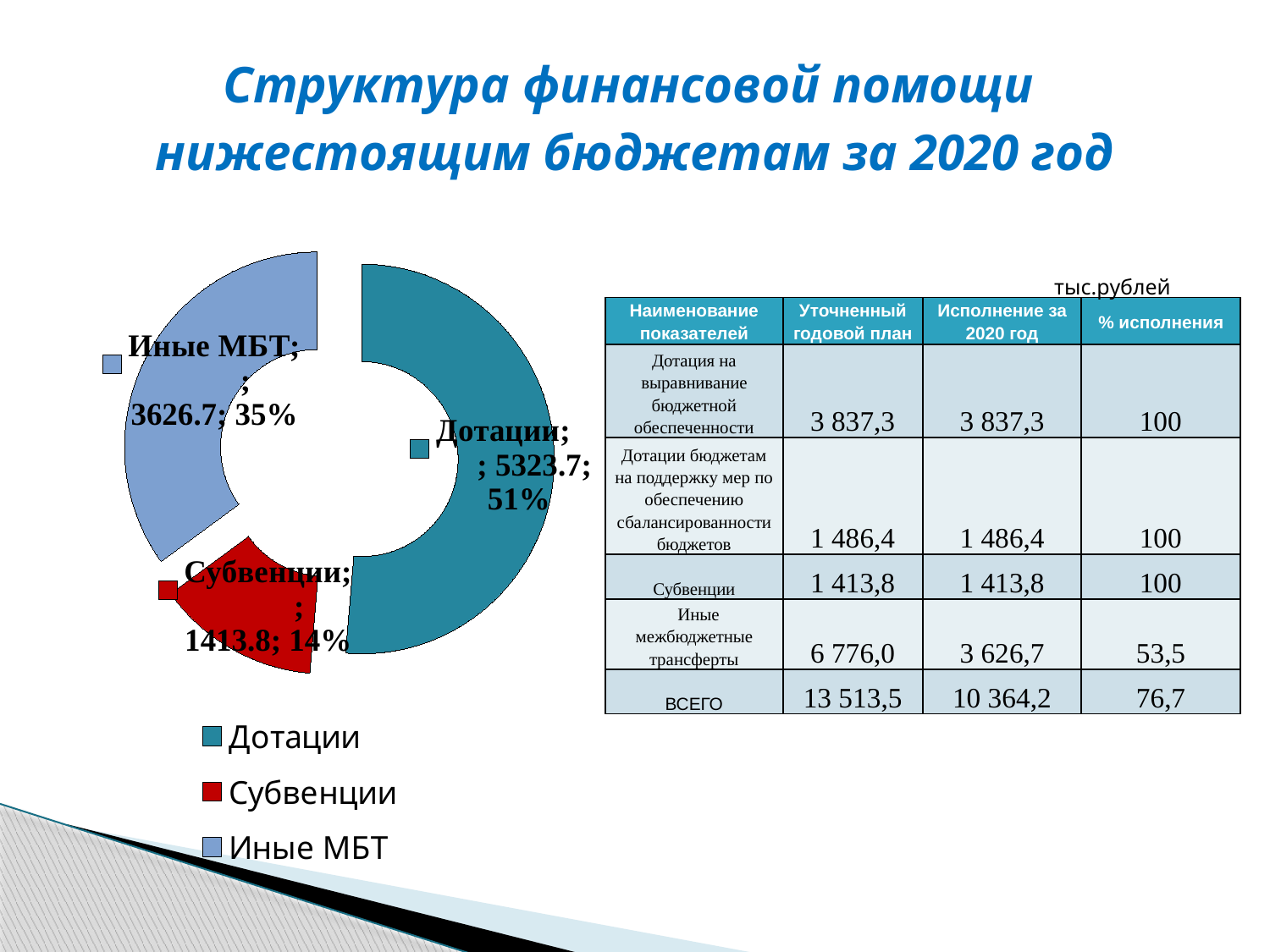
What percentage share does Дотации have in the chart? 51% What is the difference between the values for Дотации and Иные МБТ? 1697.0 What kind of chart is shown on the slide? Doughnut (pie) chart How many categories are shown in the chart? 3 What is the value shown for Дотации on the chart? 5323.7 Which category has the smallest slice in the chart? Субвенции What percentage share does Субвенции have in the chart? 14% Which category has the largest slice in the chart? Дотации What percentage share does Иные МБТ have in the chart? 35% What is the value shown for Иные МБТ on the chart? 3626.7 What is the value shown for Субвенции on the chart? 1413.8 Which is larger, the value for Иные МБТ or the value for Субвенции? Иные МБТ